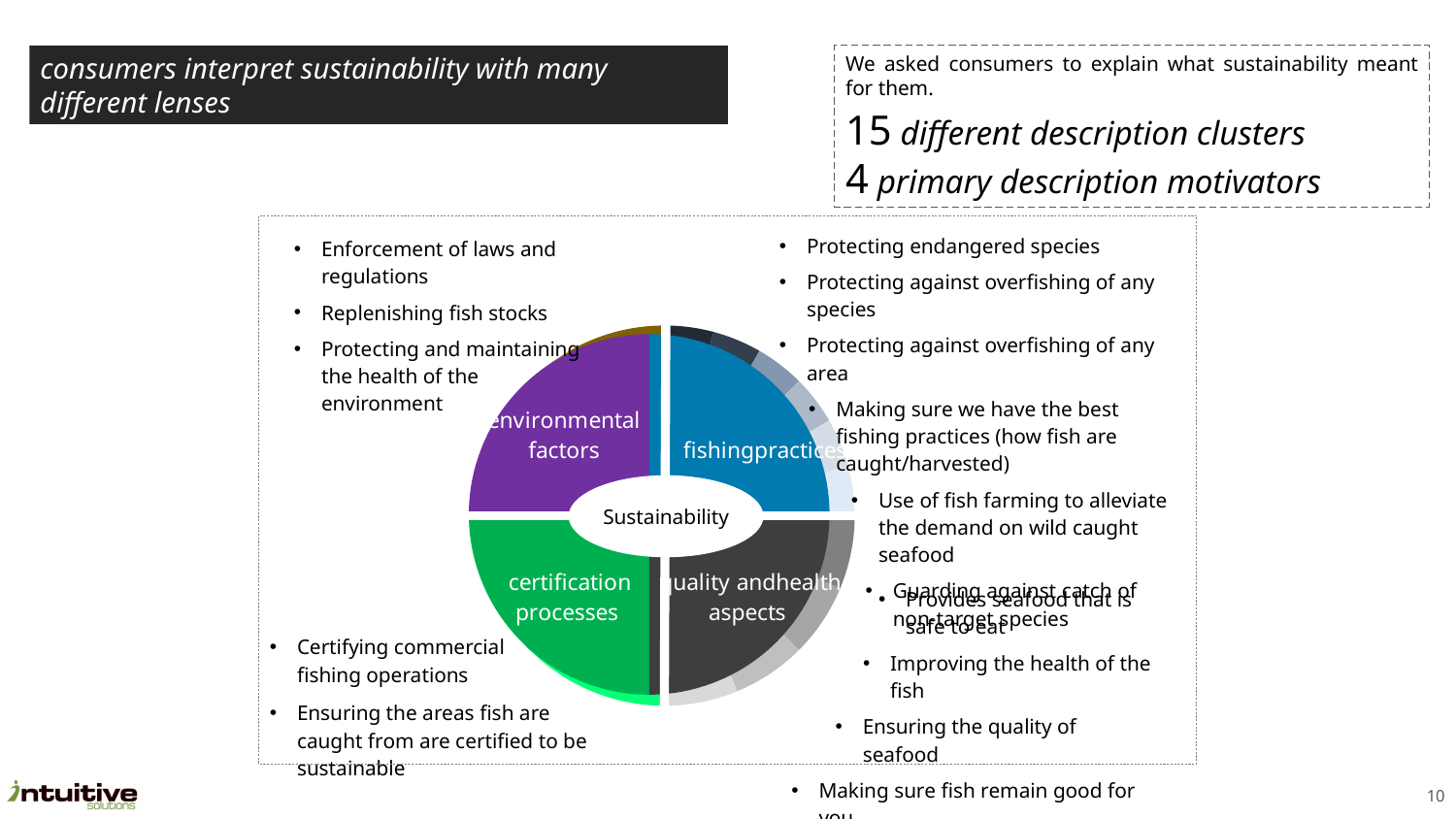
Which segment of the chart is labelled 'fishing practices'? the top-right (blue) segment What kind of chart is shown on the slide? doughnut chart Which segment of the chart is coloured purple? environmental factors How many labelled segments does the inner ring of the chart have? 4 What word appears in the centre of the chart? Sustainability Which segment of the chart is labelled 'certification processes'? the bottom-left (green) segment